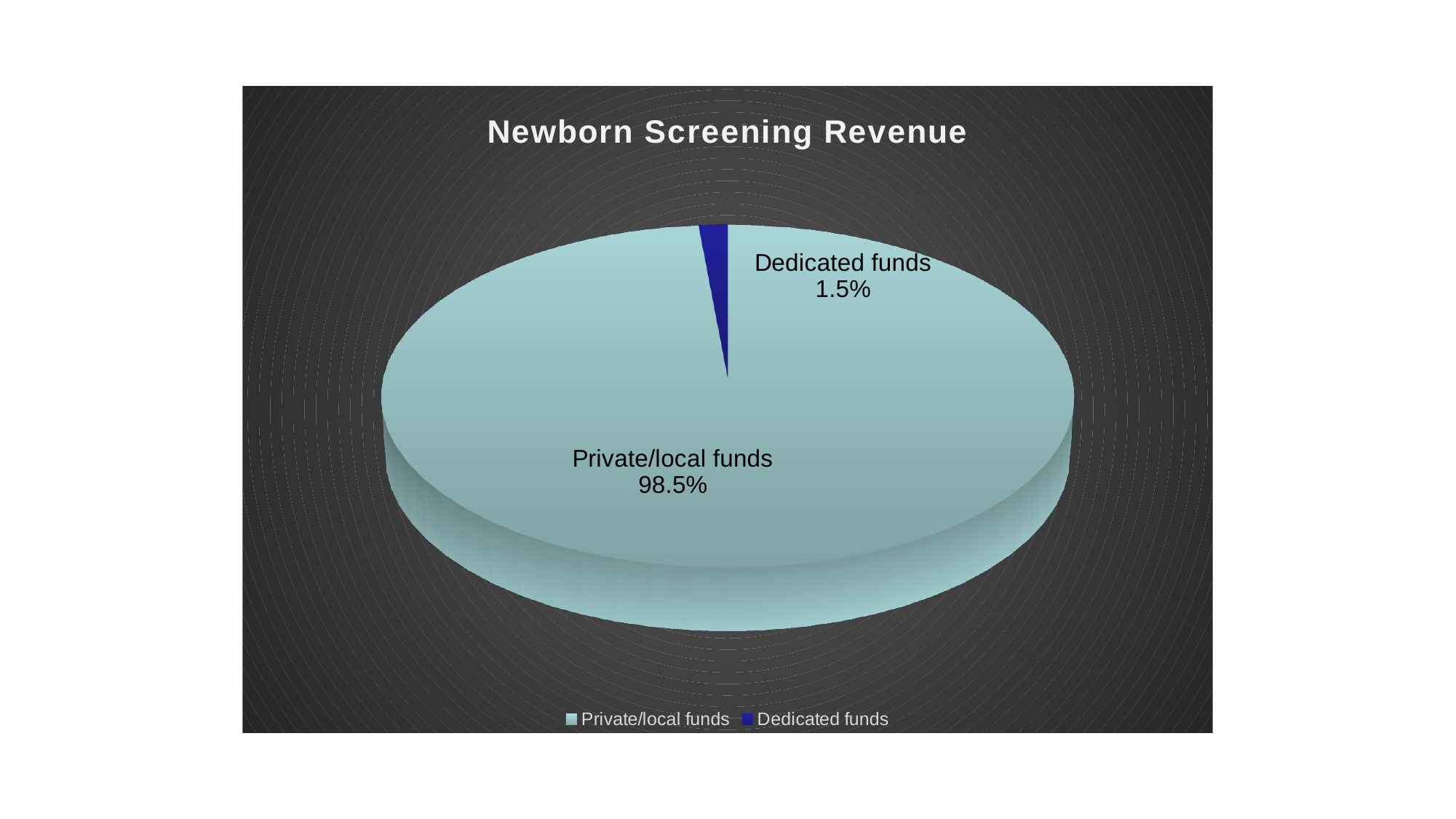
Which is larger, the share for Private/local funds or the share for Dedicated funds? Private/local funds How many entries does the legend list? 2 What colour is the Dedicated funds slice? dark blue What is the difference in percentage points between Private/local funds and Dedicated funds? 97 percentage points What share of Newborn Screening Revenue comes from Private/local funds? 98.5% What is the title of the chart? Newborn Screening Revenue How many slices does the pie chart have? 2 Which category has the largest slice of the pie? Private/local funds Is the share for Dedicated funds greater or less than 10%? less Which category has the smallest slice of the pie? Dedicated funds What share of Newborn Screening Revenue comes from Dedicated funds? 1.5% What kind of chart is shown on the slide? pie chart